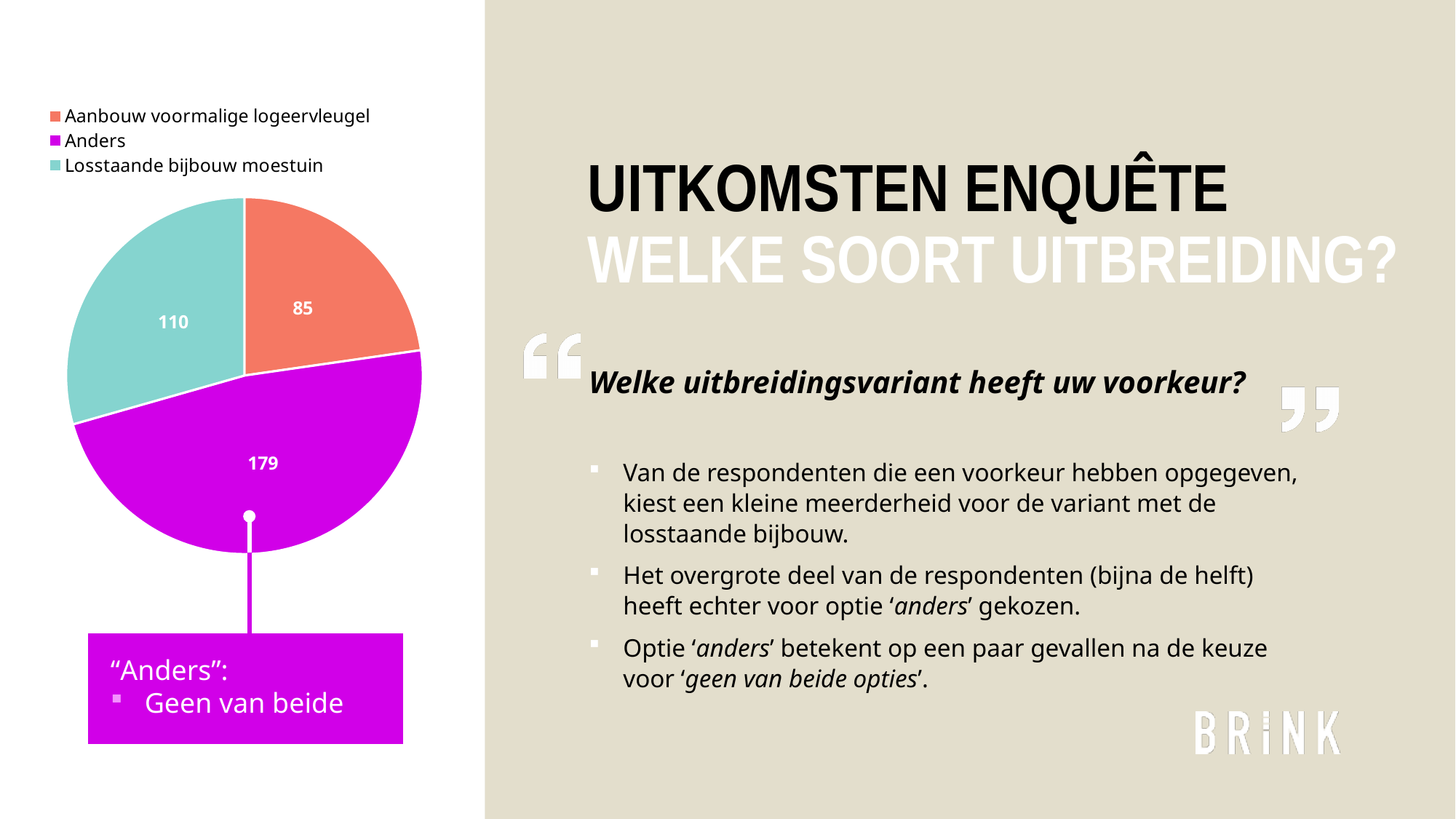
What is the difference between the values for "Losstaande bijbouw moestuin" and "Aanbouw voormalige logeervleugel"? 25 Which is larger: the value for "Losstaande bijbouw moestuin" or the value for "Aanbouw voormalige logeervleugel"? Losstaande bijbouw moestuin How many categories does the pie chart show? 3 What is the total of all slices in the pie chart? 374 What is the difference between the values for "Anders" and "Losstaande bijbouw moestuin"? 69 Which colour represents "Anders" in the pie chart? Magenta What kind of chart is shown on the slide? Pie chart What is the value for "Losstaande bijbouw moestuin" in the pie chart? 110 Which category has the largest slice in the pie chart? Anders What is the value for "Anders" in the pie chart? 179 What is the value for "Aanbouw voormalige logeervleugel" in the pie chart? 85 Which category has the smallest slice in the pie chart? Aanbouw voormalige logeervleugel